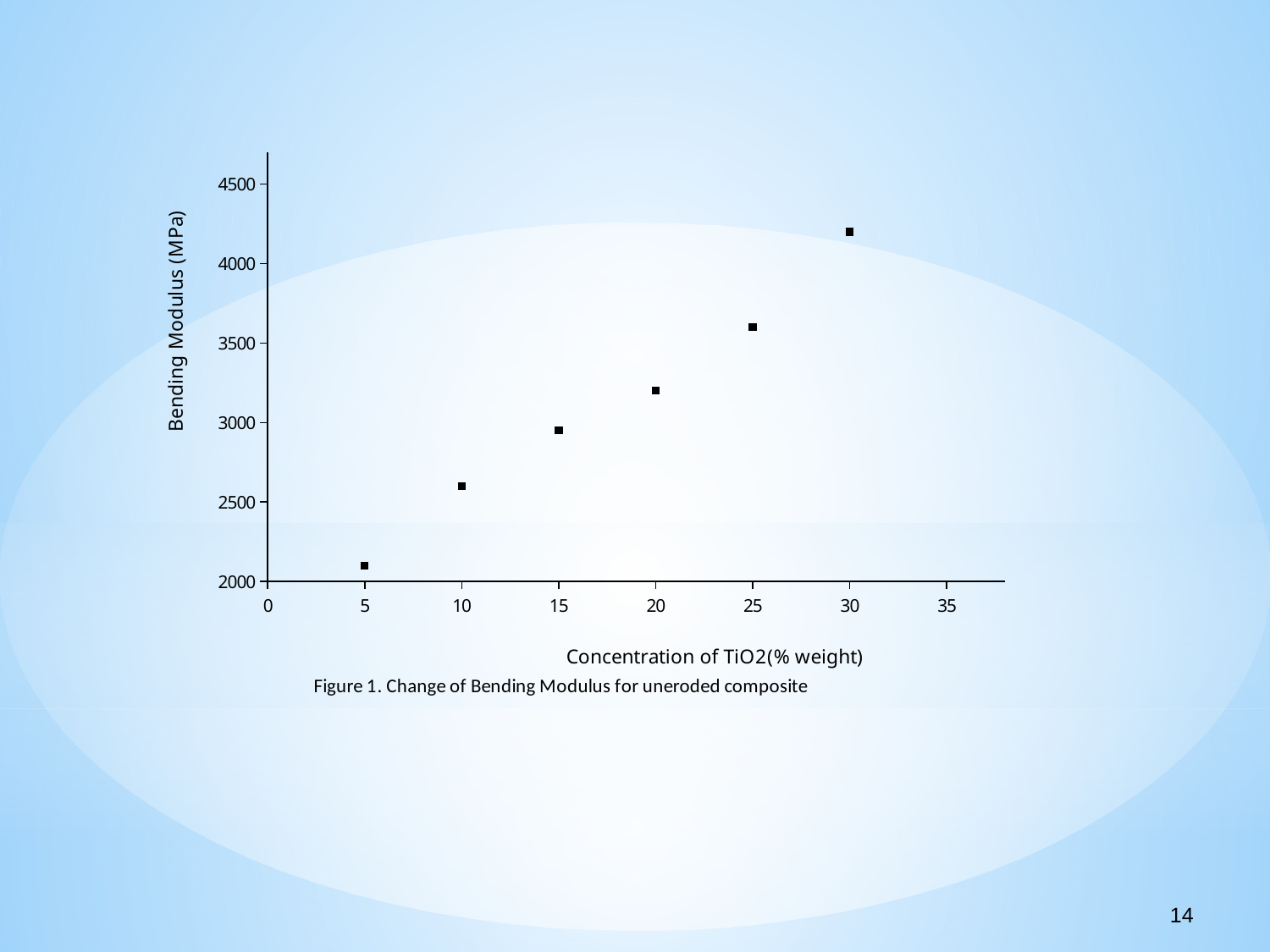
How many data points are plotted on the chart? 6 At which TiO2 concentration is the bending modulus lowest? 5 What is the label of the y axis? Bending Modulus (MPa) What is the caption of the figure? Figure 1. Change of Bending Modulus for uneroded composite Is the bending modulus at a TiO2 concentration of 25 greater or less than 3500? greater Which has a higher bending modulus: a TiO2 concentration of 15 or 25? 25 At which TiO2 concentration is the bending modulus highest? 30 Does the bending modulus rise or fall as the TiO2 concentration increases? Rises What kind of chart is shown on the slide? Scatter chart Is the bending modulus at a TiO2 concentration of 30 greater or less than 4000? greater Is the bending modulus at a TiO2 concentration of 5 greater or less than 2500? less